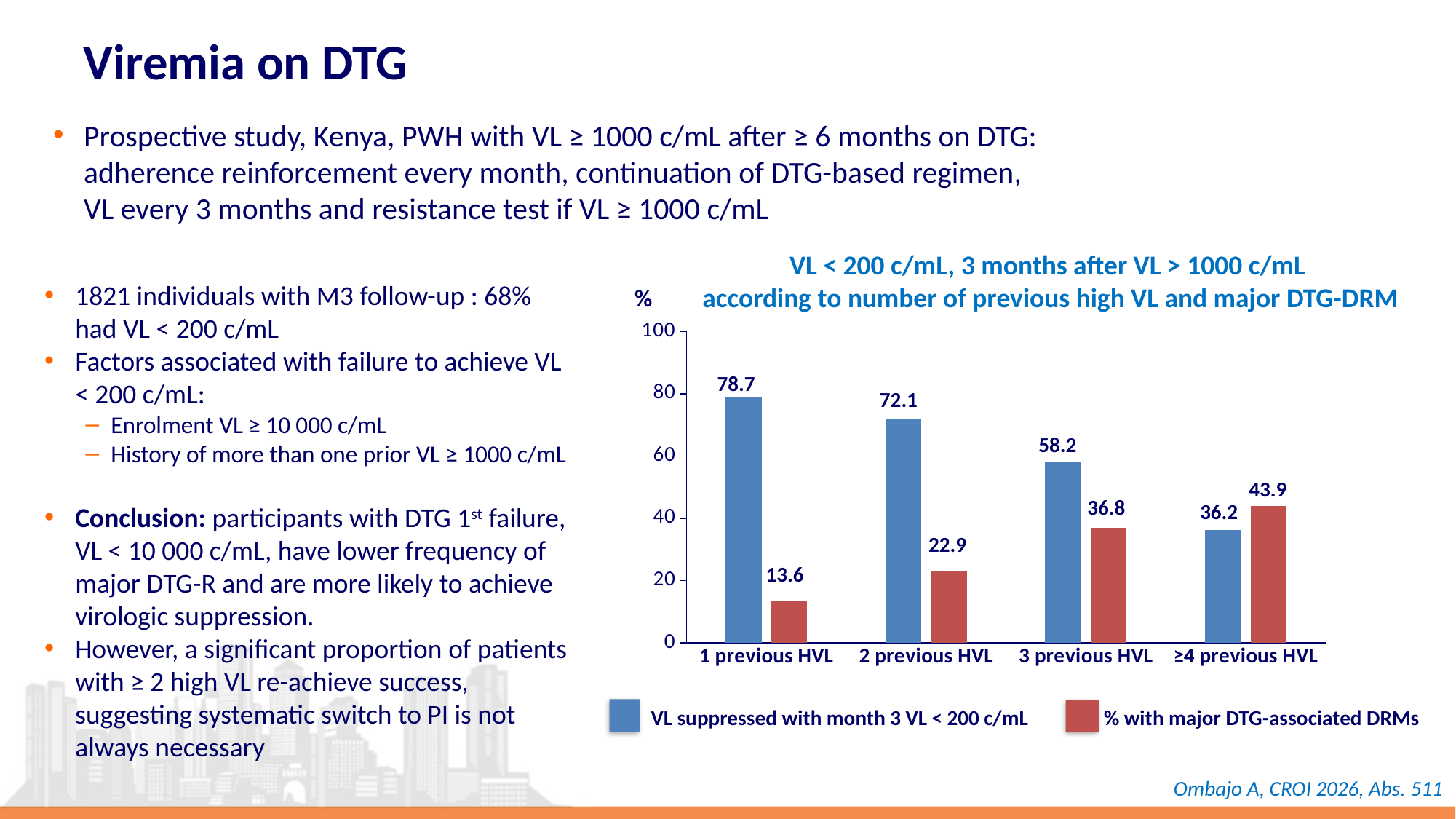
How many categories are shown on the x axis? 4 What kind of chart is shown on the slide? bar chart Is the value for % with major DTG-associated DRMs for 2 previous HVL greater or less than 40? less What is the value for % with major DTG-associated DRMs for 3 previous HVL? 36.8 For ≥4 previous HVL, which series has the larger value: VL suppressed with month 3 VL < 200 c/mL or % with major DTG-associated DRMs? % with major DTG-associated DRMs Which category has the lowest value for % with major DTG-associated DRMs? 1 previous HVL What is the value for VL suppressed with month 3 VL < 200 c/mL for 1 previous HVL? 78.7 How many series does the legend list? 2 What is the value for % with major DTG-associated DRMs for ≥4 previous HVL? 43.9 Which category has the highest value for VL suppressed with month 3 VL < 200 c/mL? 1 previous HVL Do the values for VL suppressed with month 3 VL < 200 c/mL rise or fall as the number of previous HVL increases? fall What is the difference between the VL suppressed values for 1 previous HVL and 2 previous HVL? 6.6